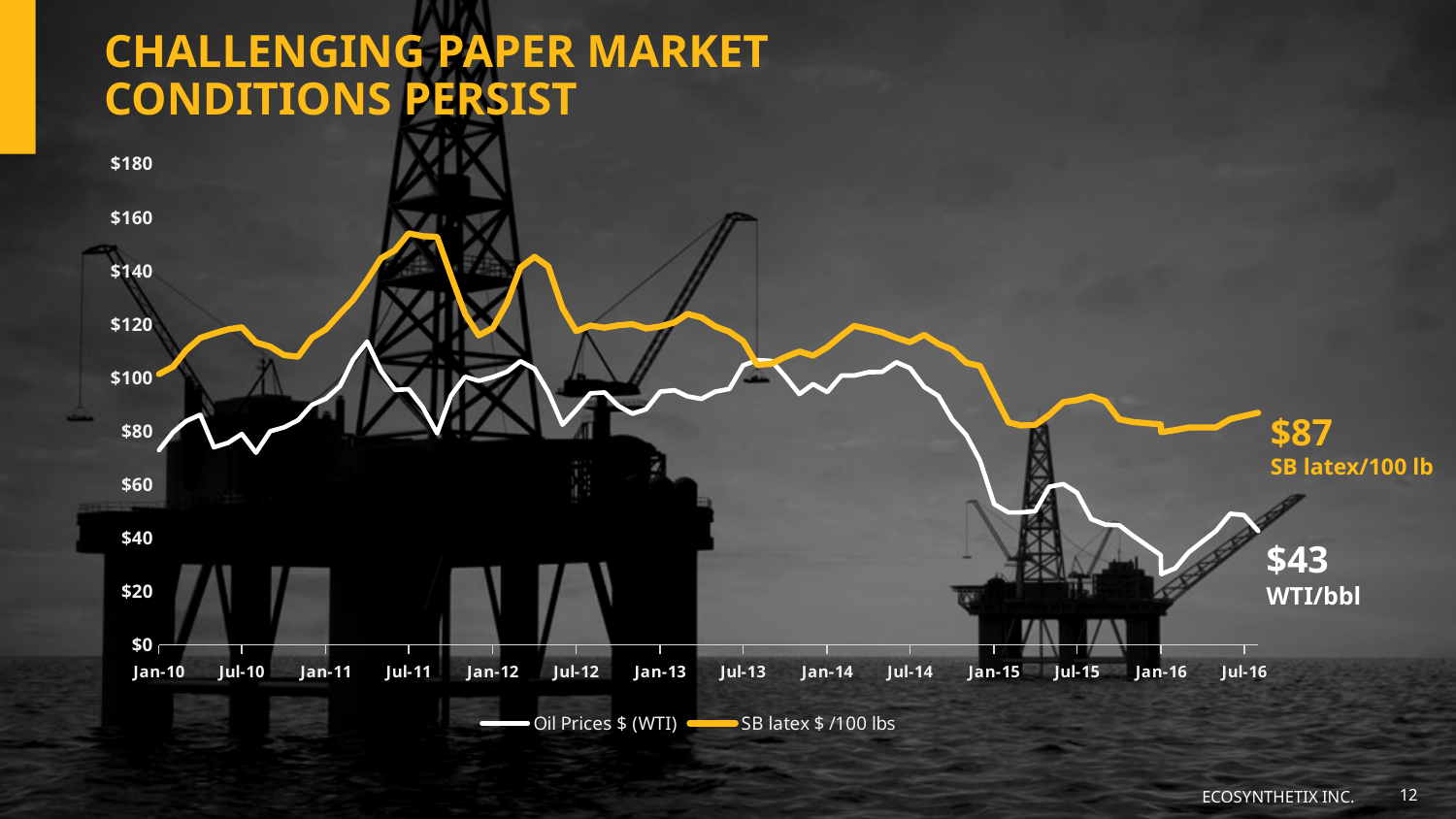
Is the peak of the SB latex line (around Jul-11) greater or less than $140? greater How many series does the legend list? 2 What is the difference between the labelled SB latex price ($87) and the labelled WTI price ($43) at the end of the chart? $44 What is the SB latex price per 100 lb at the end of the chart (Jul-16)? $87 Is the Oil Prices (WTI) value at Jan-10 greater or less than $60? greater Does the Oil Prices (WTI) line rise or fall between Jul-14 and Jan-16? Fall Is the SB latex value at Jan-10 greater or less than $120? less At the end of the chart, which series has the higher value: Oil Prices $ (WTI) or SB latex $/100 lbs? SB latex $ /100 lbs What kind of chart is shown on the slide? Line chart Which series reaches the highest value anywhere on the chart? SB latex $ /100 lbs What colour is the line for SB latex $ /100 lbs? Yellow What is the WTI oil price per barrel at the end of the chart (Jul-16)? $43